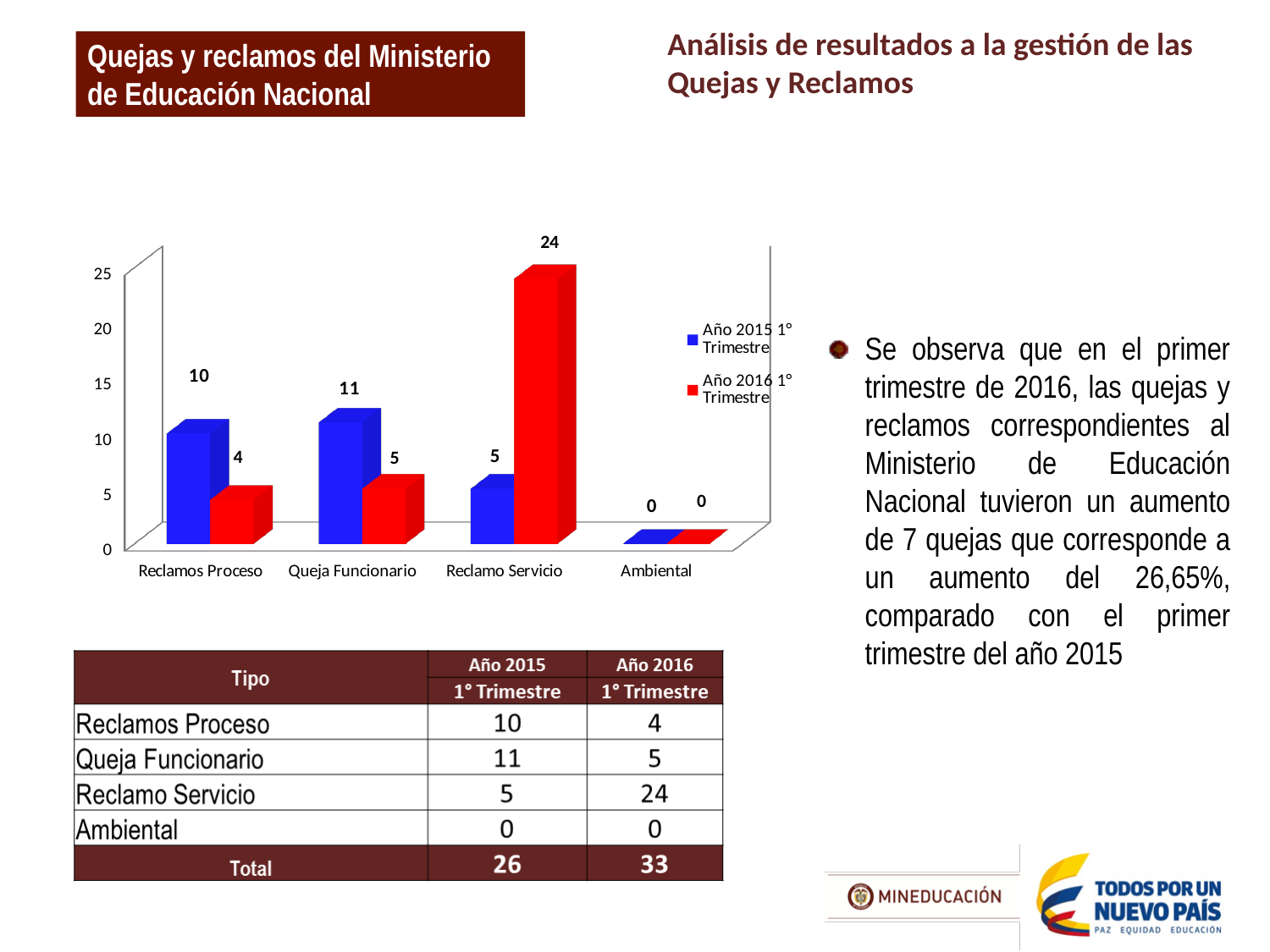
What colour represents the Año 2016 1° Trimestre series in the chart? Red What is the value for Queja Funcionario in the Año 2016 1° Trimestre series? 5 What is the difference between the Año 2016 and Año 2015 values for Reclamo Servicio? 19 Which category has the lowest value in the Año 2015 1° Trimestre series? Ambiental How many series does the chart legend list? 2 Which is larger for Reclamos Proceso: the Año 2015 1° Trimestre value or the Año 2016 1° Trimestre value? Año 2015 1° Trimestre How many categories are shown on the x axis of the chart? 4 What is the value for Reclamo Servicio in the Año 2016 1° Trimestre series? 24 What kind of chart is shown on the slide? Bar chart Which category has the highest value in the Año 2016 1° Trimestre series? Reclamo Servicio Which category has the highest value in the Año 2015 1° Trimestre series? Queja Funcionario What is the value for Reclamos Proceso in the Año 2015 1° Trimestre series? 10